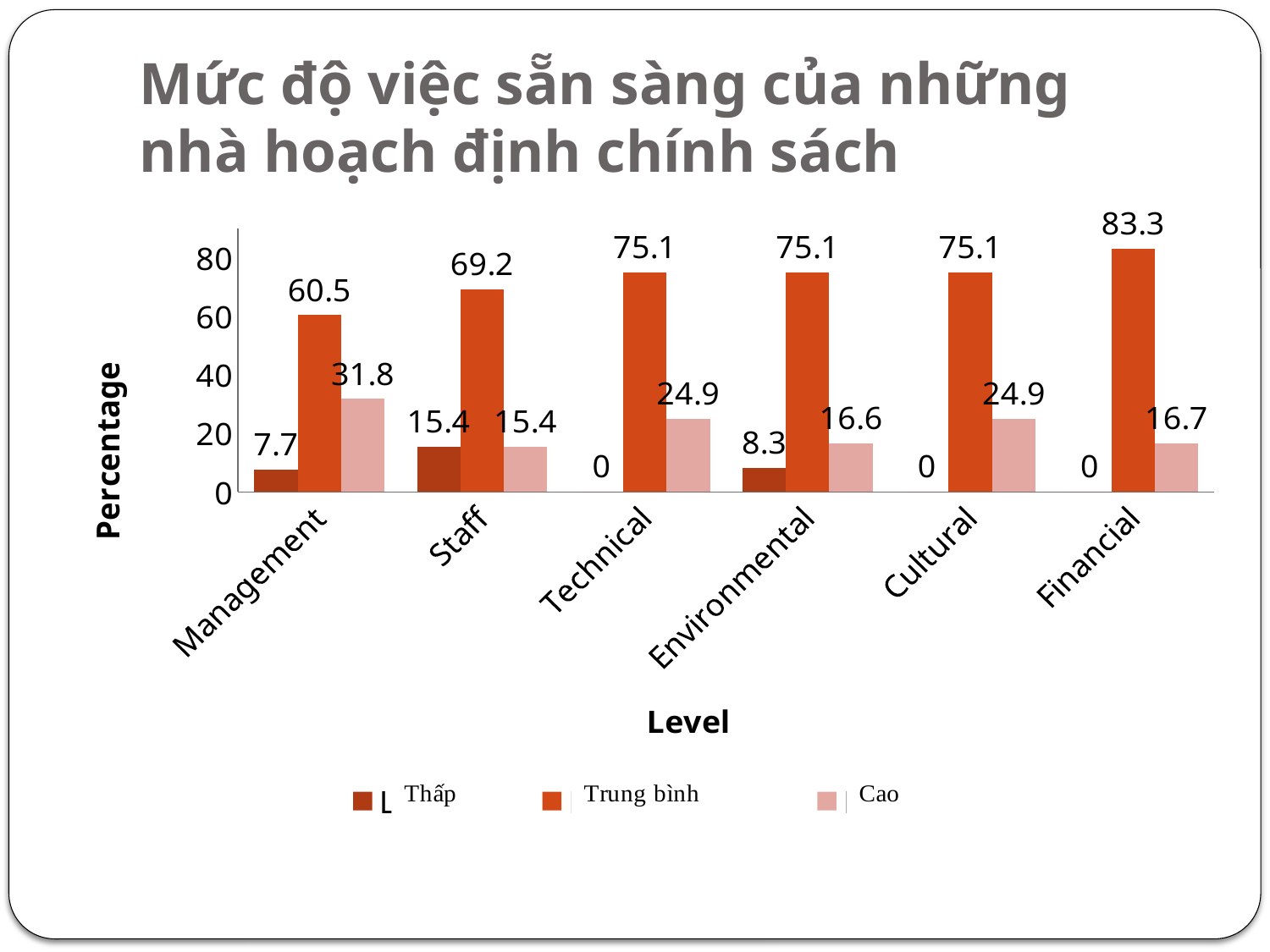
What is the value for Cao for Technical? 24.9 Which category has the highest Trung bình value? Financial What is the label of the y axis? Percentage How many categories are shown on the x axis? 6 Which category has the lowest Trung bình value? Management What kind of chart is shown on the slide? Bar chart What is the difference between the Trung bình values for Financial and Staff? 14.1 How many series does the legend list? 3 Which is larger, the Cao value for Management or the Cao value for Financial? Management What is the value for Trung bình for Management? 60.5 Is the Trung bình value for Staff greater or less than 60? greater What is the value for Thấp for Environmental? 8.3